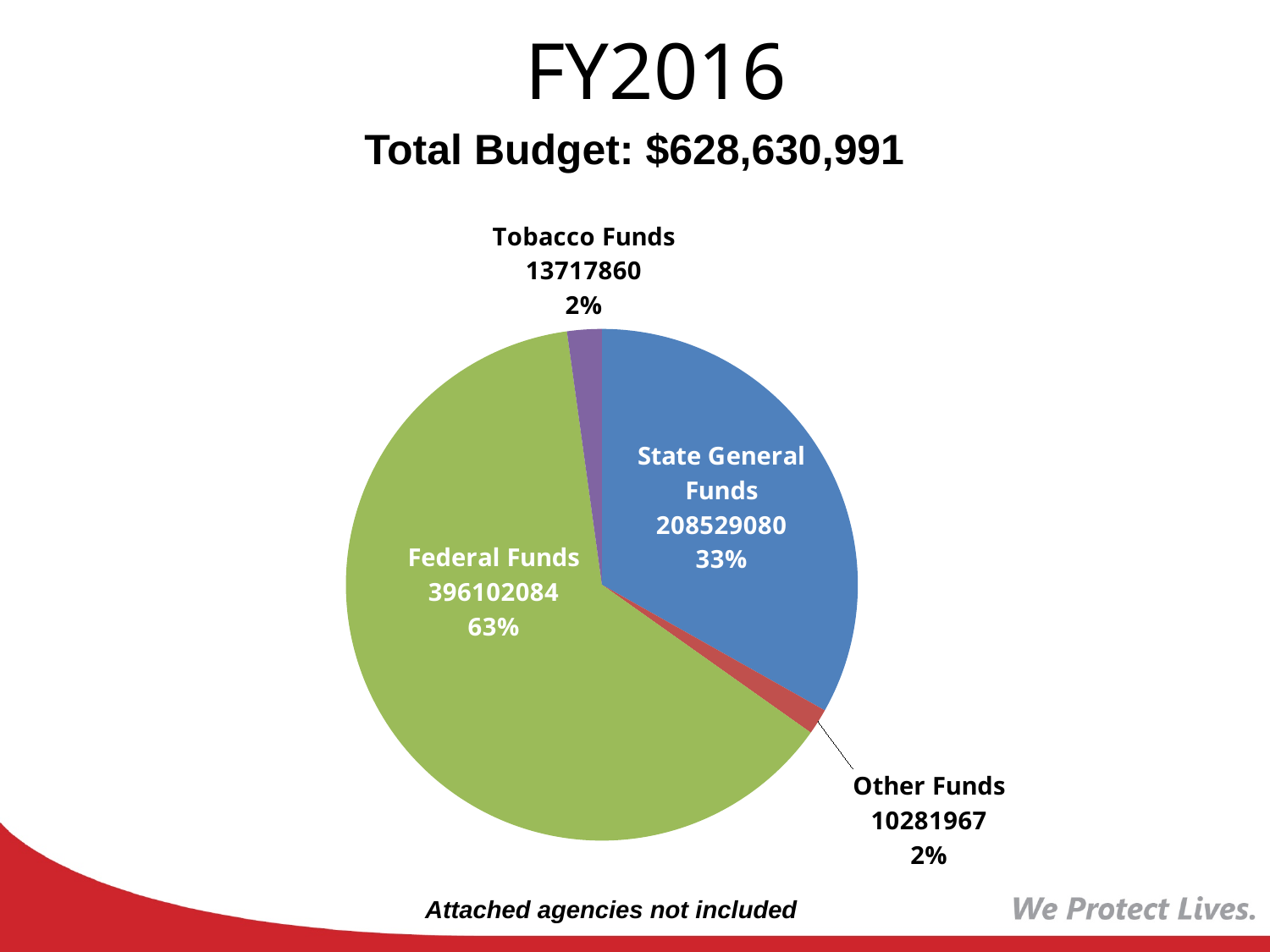
What kind of chart is shown on the slide? pie chart What is the value for Tobacco Funds? 13717860 What is the difference between Federal Funds and State General Funds? 187573004 What is the value for Federal Funds? 396102084 What share of the pie does Federal Funds represent? 63% What is the value for State General Funds? 208529080 What is the value for Other Funds? 10281967 What total budget is stated above the chart? $628,630,991 What share of the pie does State General Funds represent? 33% Which category has the largest slice of the pie? Federal Funds Which is larger, State General Funds or Federal Funds? Federal Funds How many slices does the pie chart have? 4